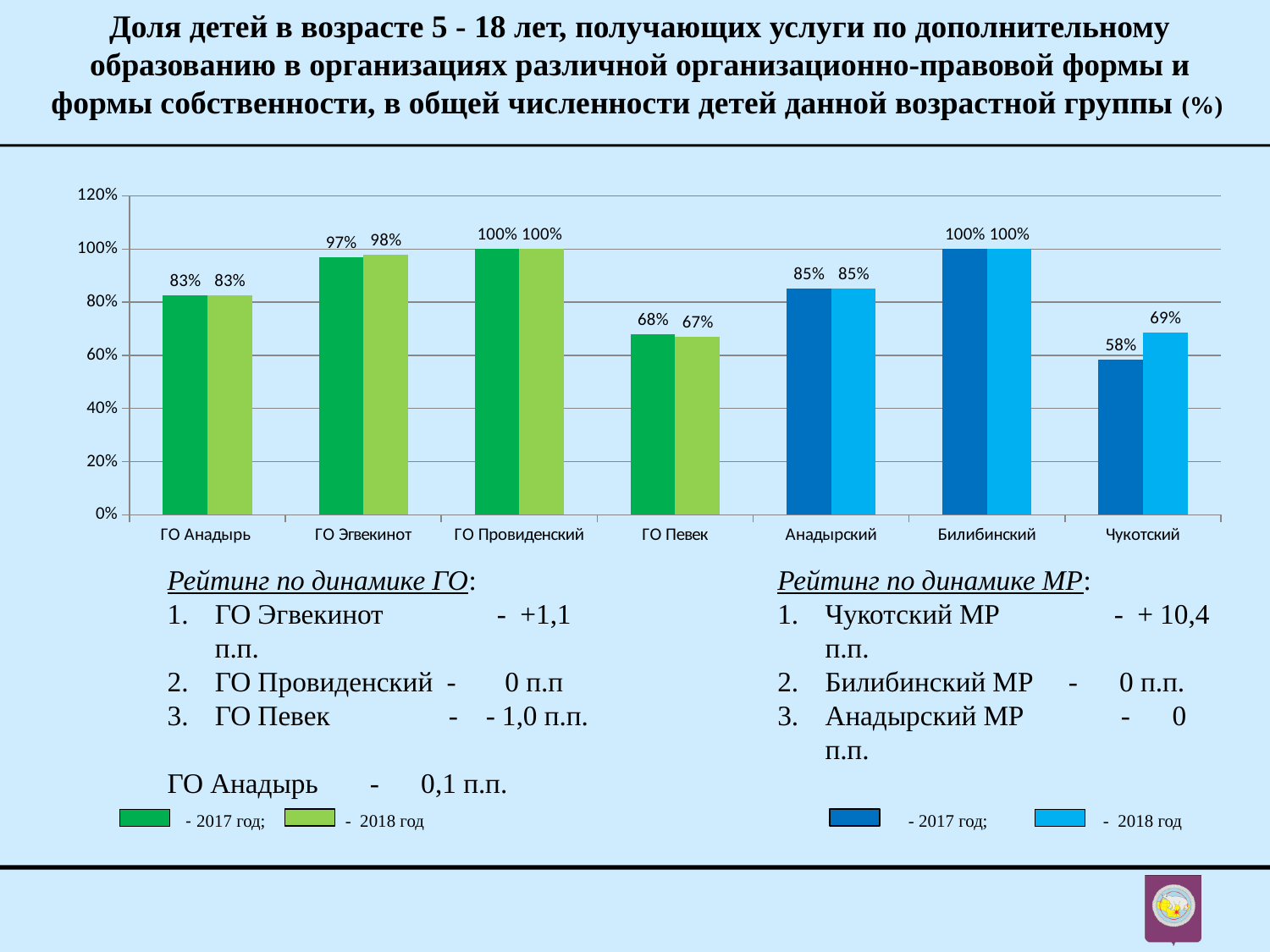
Which category has the lowest 2017 value? Чукотский What is the difference between the 2018 values for ГО Эгвекинот and ГО Певек? 31% What is the 2017 value for ГО Певек? 68% What is the 2018 value for Чукотский? 69% What kind of chart is shown on the slide? bar chart Which is larger for ГО Певек, the 2017 value or the 2018 value? 2017 What is the 2017 value for Анадырский? 85% Which category has the lowest 2018 value? ГО Певек How many categories are shown on the x axis? 7 What is the 2018 value for ГО Эгвекинот? 98% What is the difference between the 2018 and 2017 values for Чукотский? 11% Which two years are listed in the legend? 2017 год and 2018 год